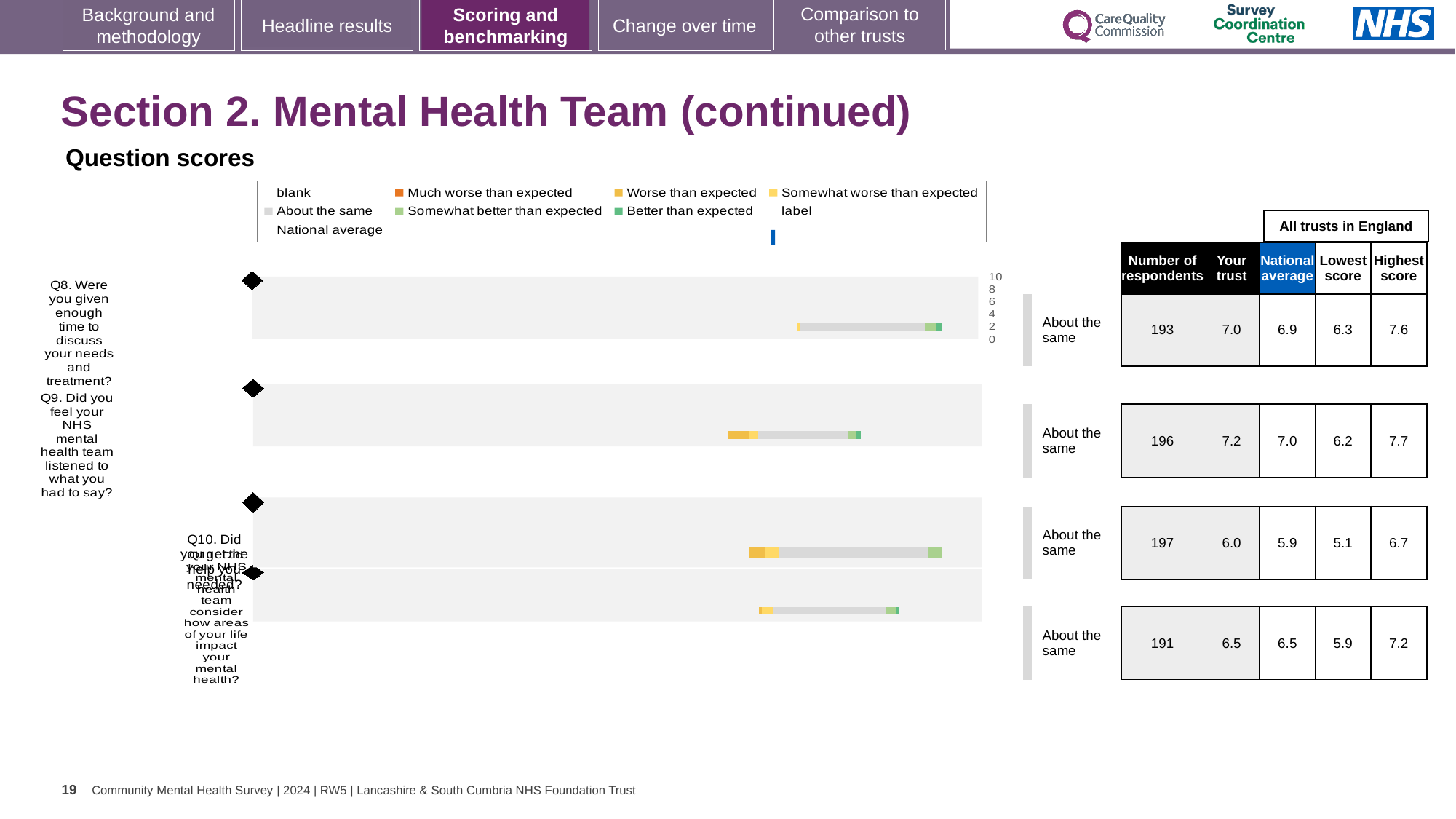
How many question bars are plotted in the question scores chart? 4 What is the heading above the chart on this slide? Question scores For Q9, what is the difference between the highest score and the lowest score among all trusts in England? 1.5 In the table beside the chart, how many respondents are listed for Q8 (Were you given enough time to discuss your needs and treatment?)? 193 Which question has the highest 'Your trust' score in the table? Q9 What is the 'Your trust' score for Q9 (Did you feel your NHS mental health team listened to what you had to say?)? 7.2 What is the national average score shown for Q8? 6.9 What is the lowest 'Your trust' score shown in the table? 6.0 What is the lowest score among all trusts in England for Q9? 6.2 What kind of chart is used to show the question scores on this slide? bar chart What benchmark category is shown next to the Q8 bar? About the same For Q8, which is larger: the 'Your trust' score or the national average? Your trust